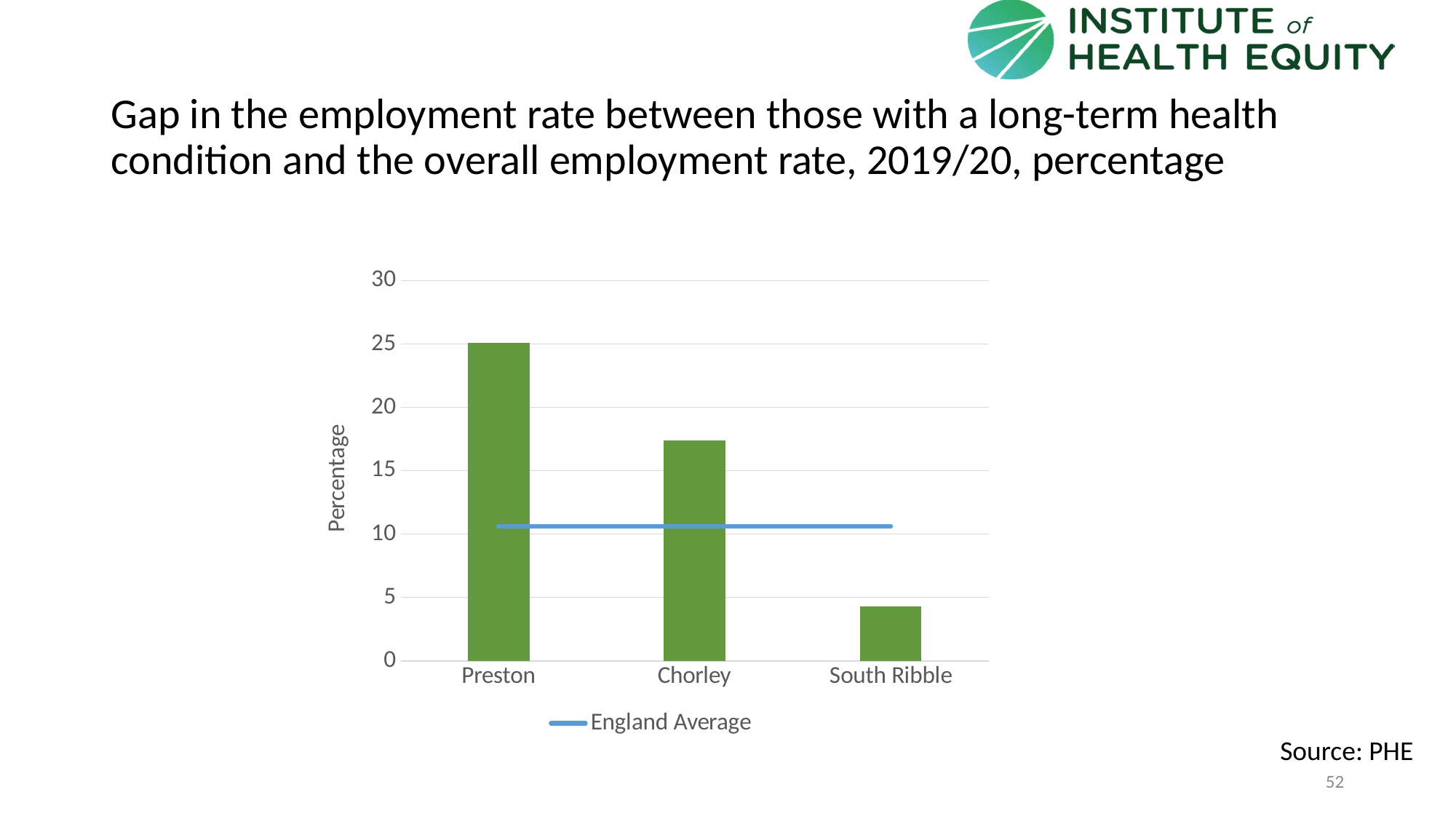
Do the bar values rise or fall from Preston to South Ribble along the x axis? fall Which has the larger value, Chorley or South Ribble? Chorley Is the value for Preston greater or less than 20? greater What is the label on the y axis of the chart? Percentage Is the England Average line greater or less than 15? less Is the value for South Ribble greater or less than 5? less How many areas are shown on the x axis of the chart? 3 Which area has the largest gap in the employment rate? Preston Which area has the smallest gap in the employment rate? South Ribble How many entries does the chart legend list? 1 What kind of chart is shown on the slide? bar chart